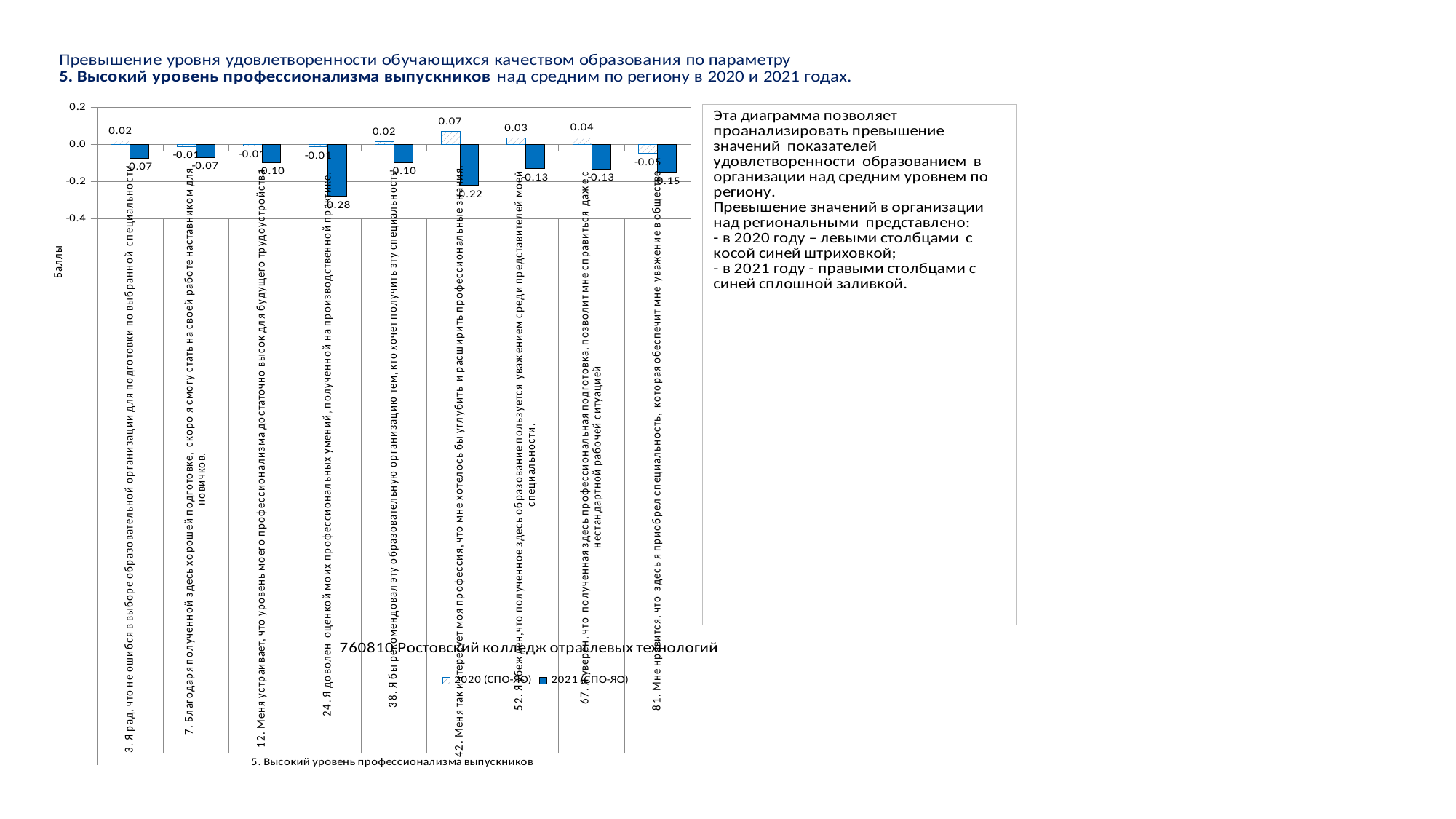
How many categories (questions) are plotted on the x axis of the chart? 9 Which category has the lowest 2021 (СПО-ЯО) value? 24. Я доволен оценкой моих профессиональных умений, полученной на производственной практике What is the difference between the 2020 and 2021 values for category 42? 0.29 According to the legend, which series is shown with hatched (striped) bars? 2020 (СПО-ЯО) How many series does the chart legend list? 2 What is the 2021 (СПО-ЯО) value for category 81 ("Мне нравится, что здесь я приобрел специальность...")? -0.15 Is the 2021 (СПО-ЯО) value for category 24 greater or less than -0.2? less What is the 2020 (СПО-ЯО) value for category 42 ("Меня так интересует моя профессия...")? 0.07 What is the 2021 (СПО-ЯО) value for category 24 ("Я доволен оценкой моих профессиональных умений...")? -0.28 Which is larger: the 2021 value for category 3 or the 2021 value for category 24? category 3 (-0.07) Which category has the highest 2020 (СПО-ЯО) value? 42. Меня так интересует моя профессия, что мне хотелось бы углубить и расширить профессиональные знания What kind of chart is shown on the slide? bar chart